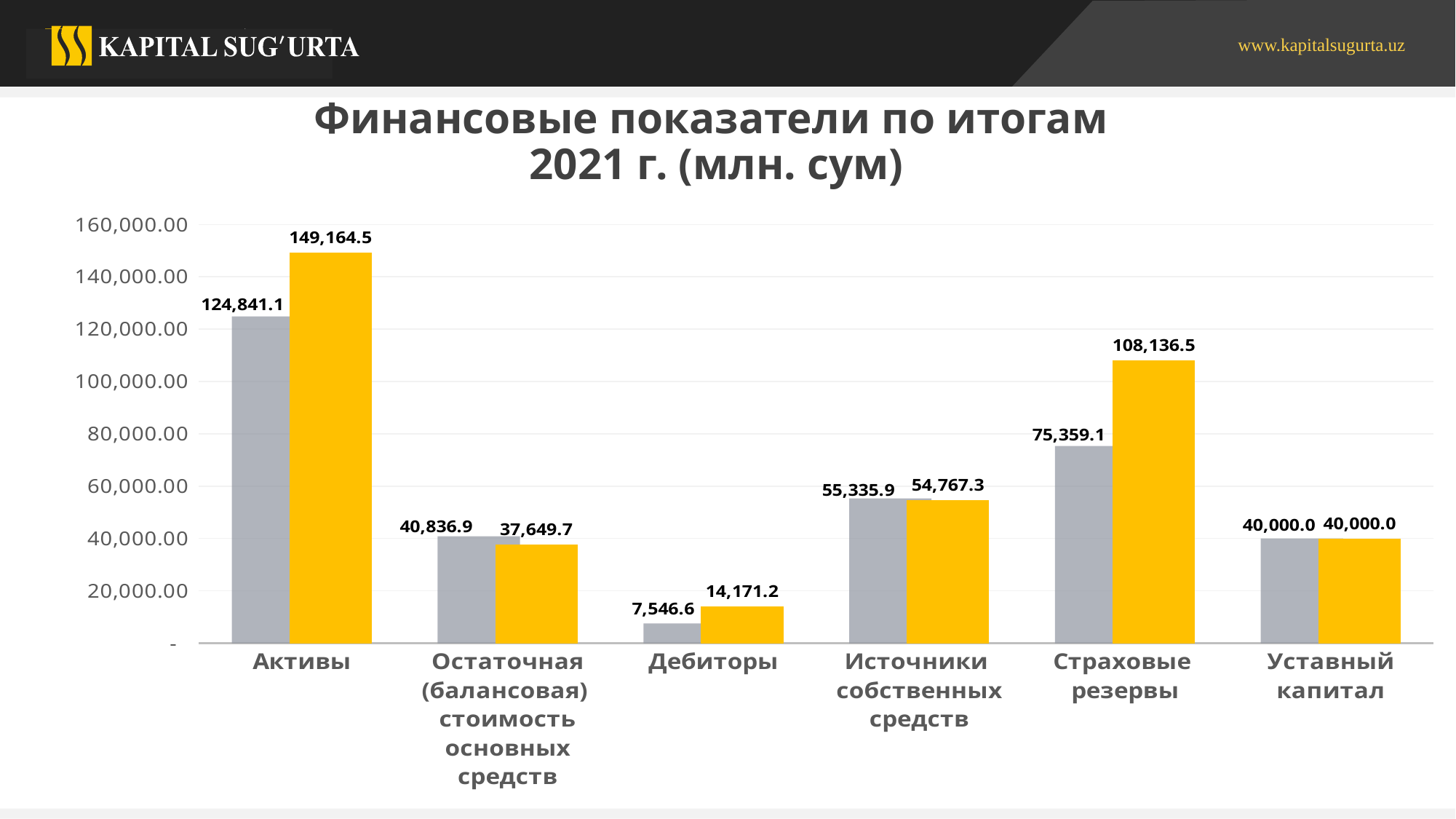
What is the difference between the yellow and grey bars for Страховые резервы? 32,777.4 What is the value of the grey bar for Дебиторы? 7,546.6 Which category has the lowest grey bar? Дебиторы For Остаточная (балансовая) стоимость основных средств, which bar is larger, grey or yellow? grey Which category has the highest yellow bar? Активы What is the value of the yellow bar for Источники собственных средств? 54,767.3 What is the value of the grey bar for Страховые резервы? 75,359.1 How many categories are shown on the x axis? 6 What is the value of the yellow bar for Активы? 149,164.5 What is the difference between the yellow and grey bars for Активы? 24,323.4 What type of chart is shown on the slide? bar chart What is the title of the chart? Финансовые показатели по итогам 2021 г. (млн. сум)